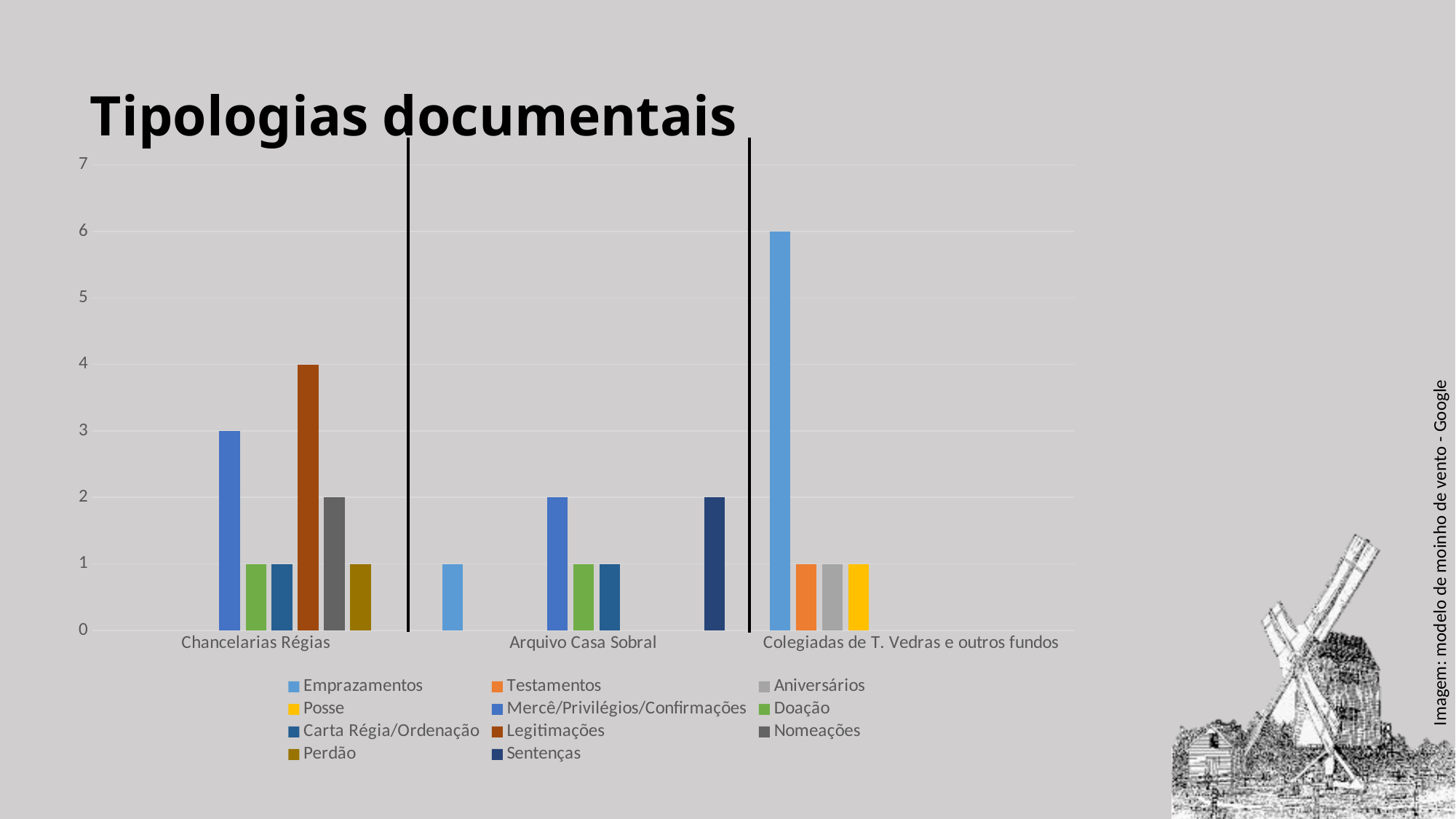
What is the value for Emprazamentos in the Colegiadas de T. Vedras e outros fundos category? 6 How many categories are shown on the x axis? 3 What is the value for Legitimações in the Chancelarias Régias category? 4 Which series has the highest value in the Colegiadas de T. Vedras e outros fundos category? Emprazamentos How many series does the legend list? 11 What is the value for Mercê/Privilégios/Confirmações in the Arquivo Casa Sobral category? 2 What is the value for Nomeações in the Chancelarias Régias category? 2 Which is larger: Emprazamentos in Colegiadas de T. Vedras e outros fundos or Legitimações in Chancelarias Régias? Emprazamentos in Colegiadas de T. Vedras e outros fundos Which series has the highest value in the Chancelarias Régias category? Legitimações What is the title of the slide? Tipologias documentais What is the difference between Legitimações and Mercê/Privilégios/Confirmações in the Chancelarias Régias category? 1 What kind of chart is shown on the slide? Bar chart